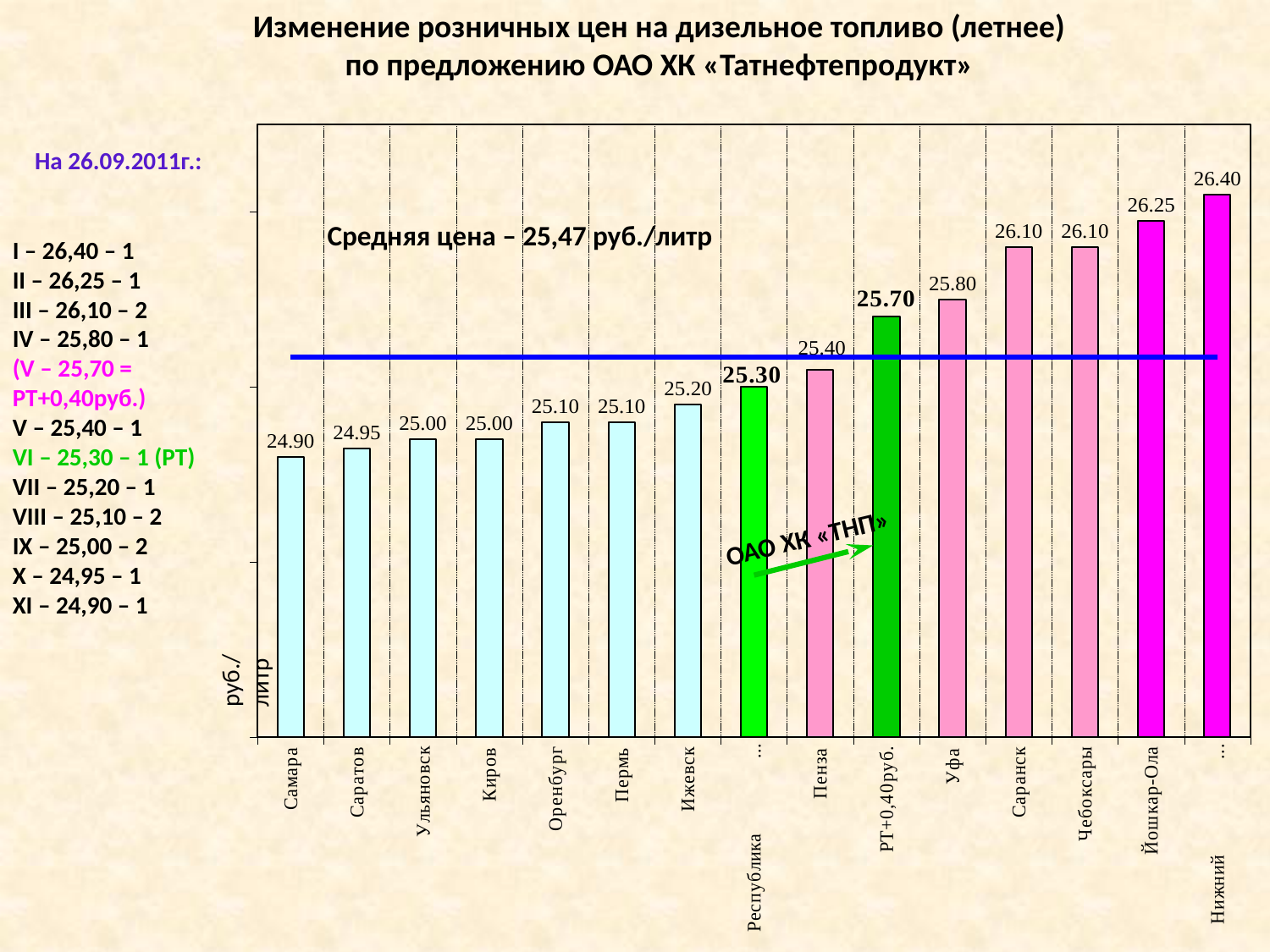
What is the value for the bar labelled РТ+0,40руб.? 25.70 What is the value for Йошкар-Ола? 26.25 What is the difference between the values for Уфа and Ижевск? 0.60 Which is larger, the value for Саратов or the value for Оренбург? Оренбург What average price is stated in the text inside the chart? 25,47 руб./литр Which category has the highest value? Нижний What is the value for Пенза? 25.40 Do the values rise or fall from left to right along the x axis? Rise What is the value for Самара? 24.90 Which category has the lowest value? Самара What kind of chart is shown on the slide? Bar chart with a horizontal line showing the average price How many bars are plotted in the chart? 15